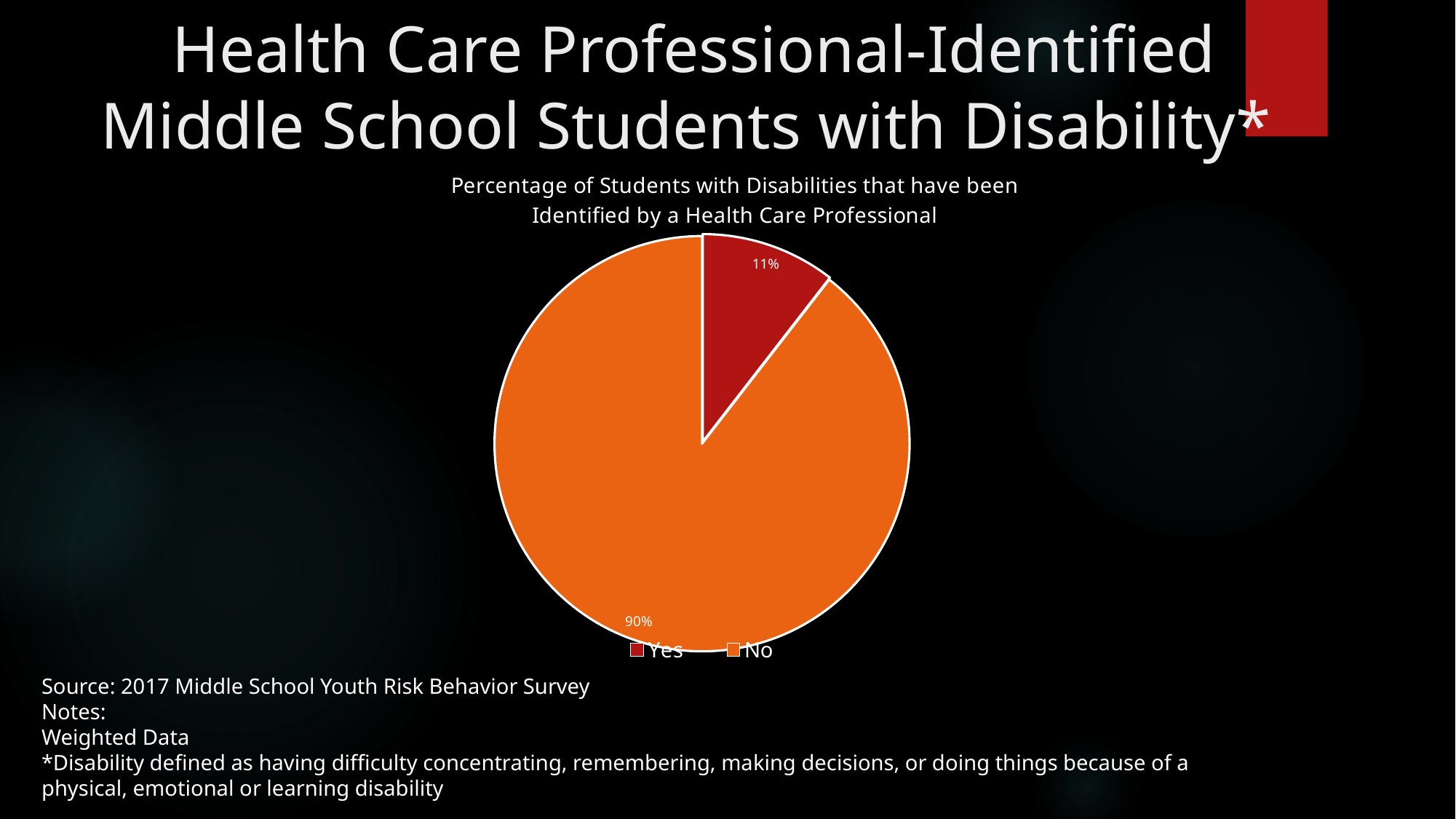
How many entries does the legend list? 2 How many slices does the pie chart have? 2 What percentage is shown for the "Yes" slice? 11% Which slice is larger, "Yes" or "No"? No Which slice is the largest? No What kind of chart is shown on the slide? pie chart What colour is the "Yes" slice? red Which slice is the smallest? Yes What percentage is shown for the "No" slice? 90% What is the title of the chart? Percentage of Students with Disabilities that have been Identified by a Health Care Professional What is the difference in percentage points between the "No" slice and the "Yes" slice? 79